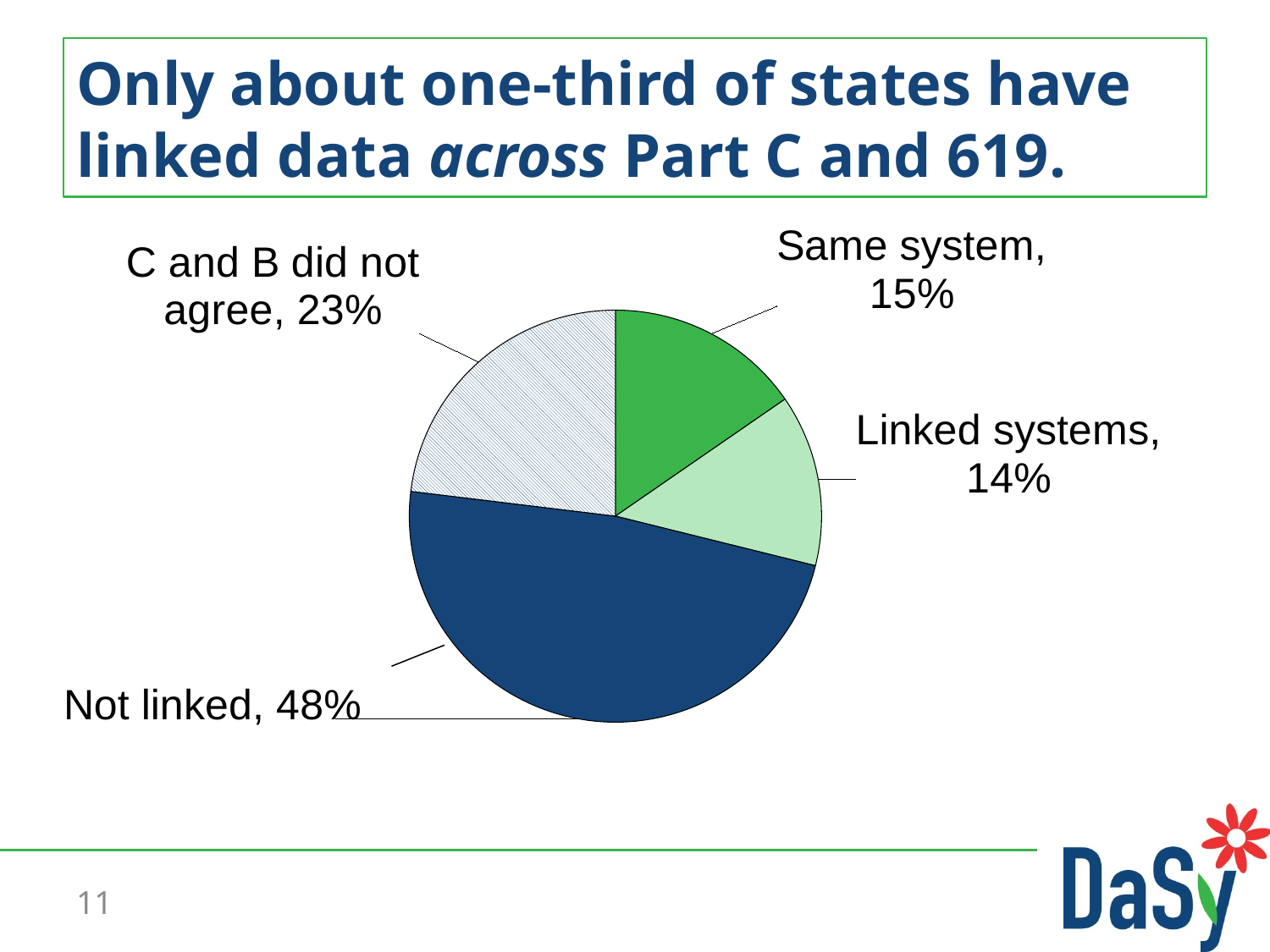
What percentage of states are in the 'Not linked' category? 48% Which category has the largest share of the pie? Not linked Which slice of the pie is drawn with a hatched (striped) pattern? C and B did not agree Which category has the smallest share of the pie? Linked systems What kind of chart is shown on the slide? pie chart What percentage of states have the 'Same system'? 15% What is the combined percentage of 'Same system' and 'Linked systems'? 29% What percentage is shown for 'C and B did not agree'? 23% What is the difference in percentage points between 'Not linked' and 'C and B did not agree'? 25 How many slices does the pie chart have? 4 What percentage of states have 'Linked systems'? 14% Which is larger, the share for 'Same system' or the share for 'Linked systems'? Same system